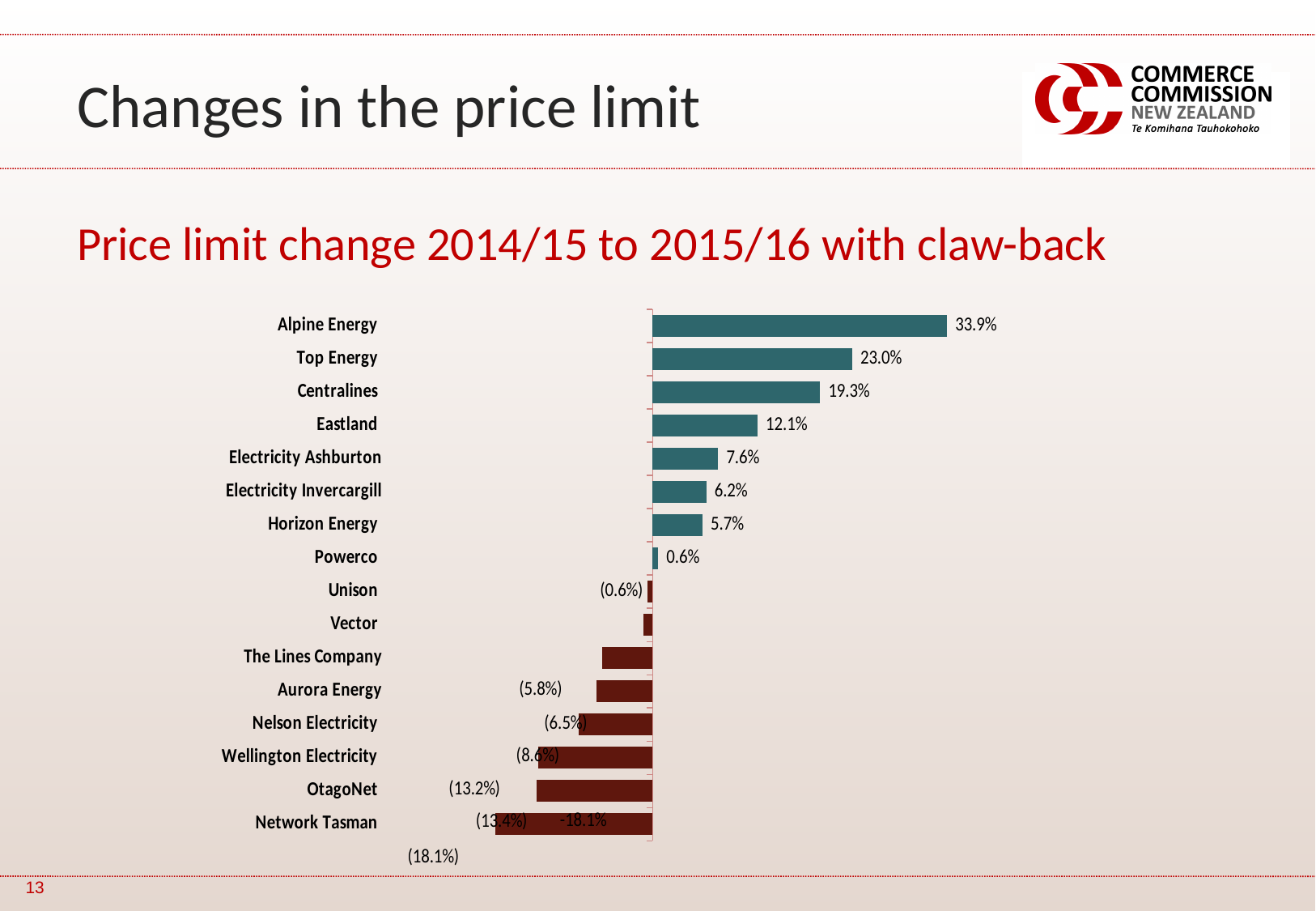
What is the price limit change for Unison? (0.6%) Which has a larger price limit change, Electricity Ashburton or Horizon Energy? Electricity Ashburton How many companies are listed on the chart? 16 What is the title of the chart? Price limit change 2014/15 to 2015/16 with claw-back Which company has the lowest (most negative) price limit change? Network Tasman What is the price limit change for Centralines? 19.3% What is the price limit change for Alpine Energy? 33.9% What is the difference between the price limit changes for Alpine Energy and Top Energy? 10.9% What is the price limit change for Powerco? 0.6% What is the price limit change for Eastland? 12.1% What kind of chart is shown on the slide? Bar chart Which company has the highest price limit change? Alpine Energy